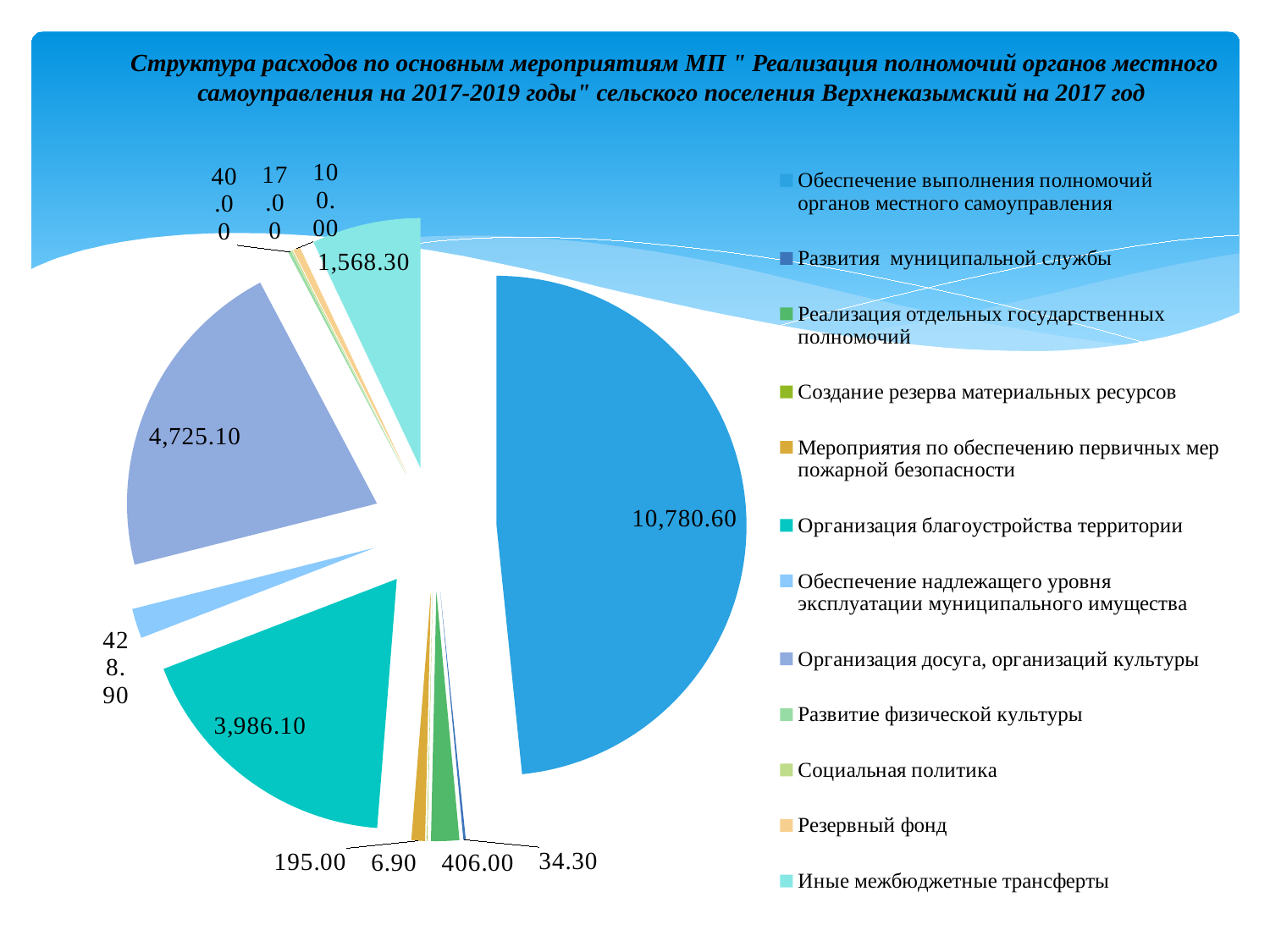
What type of chart is shown on the slide? pie chart What is the value for Иные межбюджетные трансферты? 1,568.30 What is the value for Организация досуга, организаций культуры? 4,725.10 How many categories does the legend of the pie chart list? 12 What is the value for Развития муниципальной службы? 34.30 Which category has the smallest value in the pie chart? Создание резерва материальных ресурсов What is the value for Реализация отдельных государственных полномочий? 406.00 What is the difference between the values for Организация досуга, организаций культуры and Организация благоустройства территории? 739.00 What colour is the largest slice of the pie chart? blue Which category has the largest slice of the pie? Обеспечение выполнения полномочий органов местного самоуправления Which is larger: the value for Реализация отдельных государственных полномочий or the value for Мероприятия по обеспечению первичных мер пожарной безопасности? Реализация отдельных государственных полномочий What is the value for Организация благоустройства территории? 3,986.10